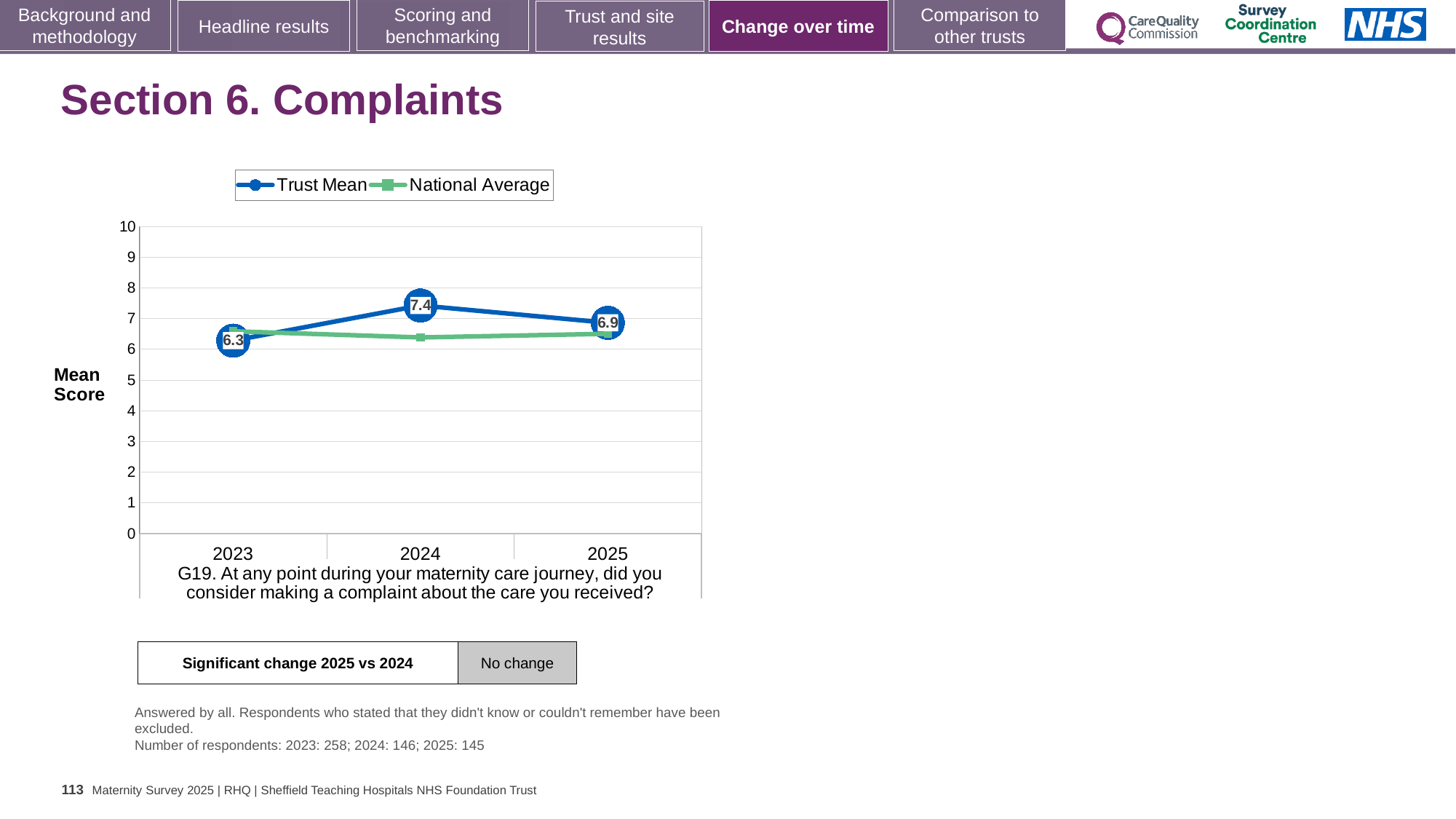
By how much did the Trust Mean score increase from 2023 to 2024? 1.1 How many years are shown on the x axis of the chart? 3 What is the difference between the Trust Mean scores for 2024 and 2025? 0.5 What is the Trust Mean score for 2023? 6.3 What kind of chart is shown on the slide? line chart What is the Trust Mean score for 2024? 7.4 In 2024, which series has the higher value: Trust Mean or National Average? Trust Mean In which year was the Trust Mean score highest? 2024 What is the Trust Mean score for 2025? 6.9 Is the National Average value for 2024 greater or less than 7? less How many series does the chart legend list? 2 In which year was the Trust Mean score lowest? 2023